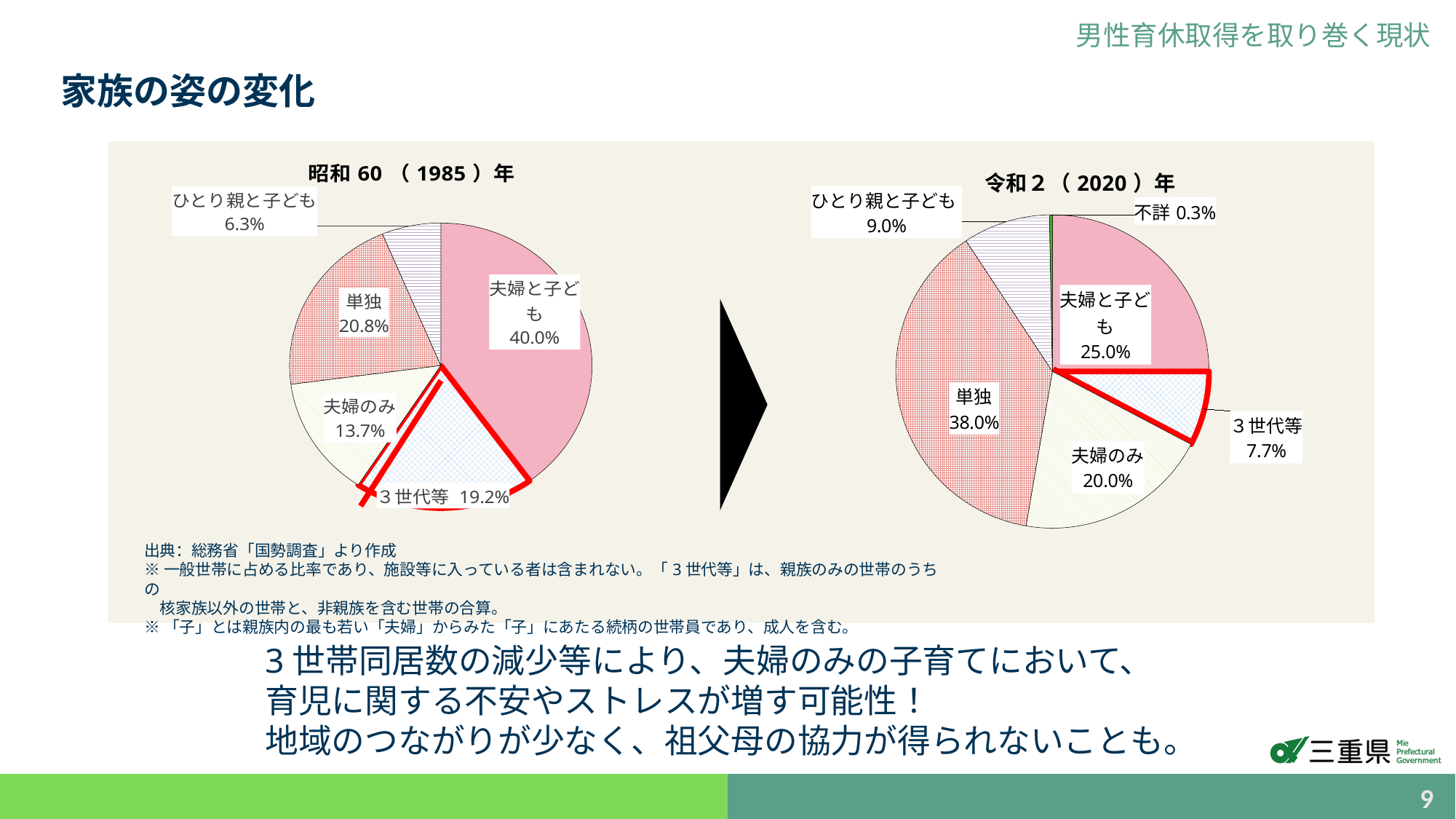
How many categories are shown in the 令和2（2020）年 pie chart? 6 In the 令和2（2020）年 pie chart, which category has the smallest share? 不詳 In the 令和2（2020）年 pie chart, what is the share for 単独? 38.0% In the 昭和60（1985）年 pie chart, which category has the largest share? 夫婦と子ども In the 令和2（2020）年 pie chart, which is larger: 単独 or 夫婦と子ども? 単独 In the 昭和60（1985）年 pie chart, which category has the smallest share? ひとり親と子ども What type of chart is used for the 昭和60（1985）年 data? Pie chart What is the difference between the 3世代等 share in the 昭和60（1985）年 chart and in the 令和2（2020）年 chart? 11.5% In the 昭和60（1985）年 pie chart, what is the difference between the 単独 share and the 夫婦のみ share? 7.1% In the 令和2（2020）年 pie chart, what is the share for 3世代等? 7.7% In the 昭和60（1985）年 pie chart, what is the share for 夫婦と子ども? 40.0% How many categories are shown in the 昭和60（1985）年 pie chart? 5